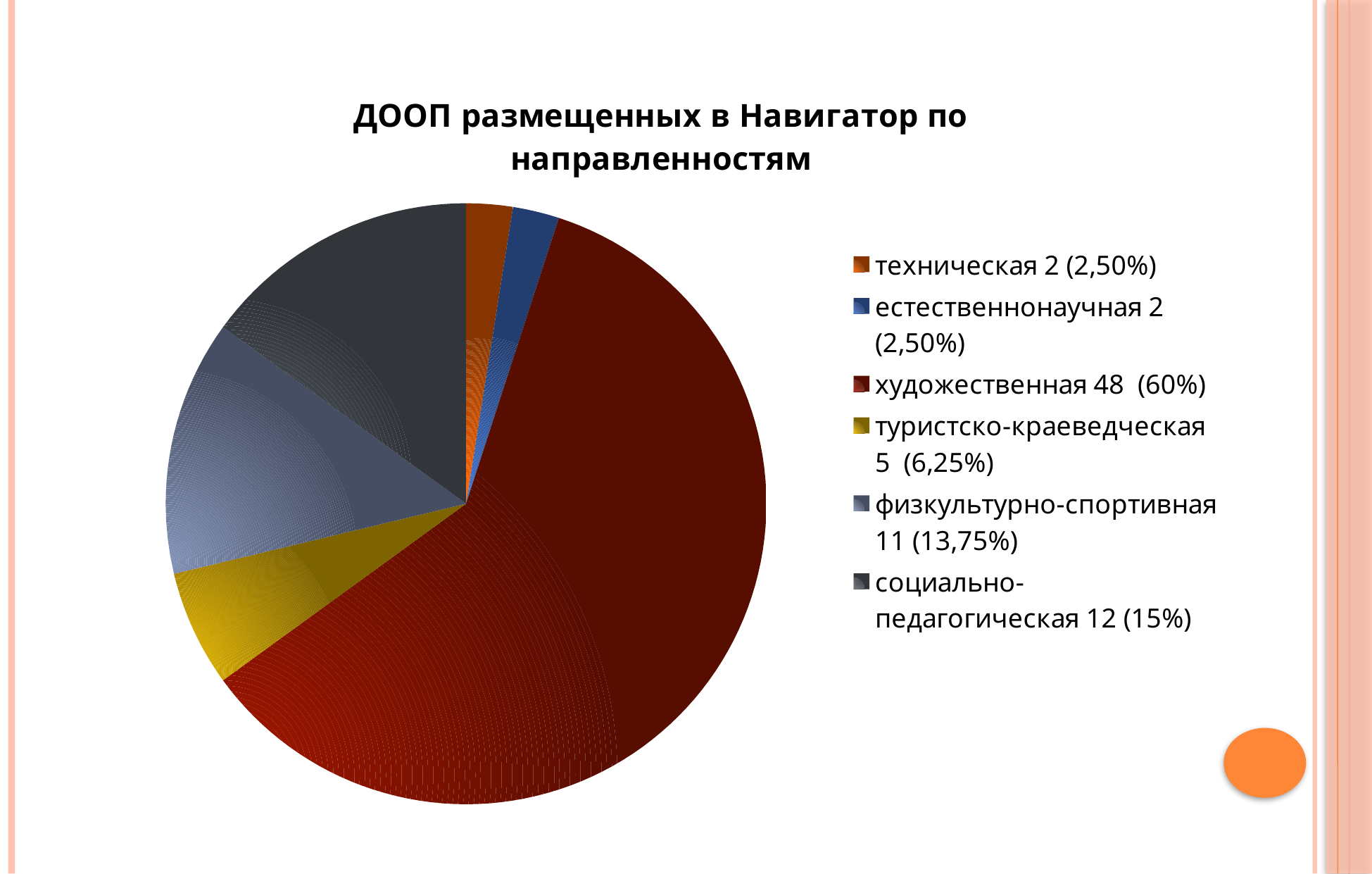
What is the total of all the values shown in the legend? 80 What share of the pie does туристско-краеведческая take? 6,25% What is the title of the chart? ДООП размещенных в Навигатор по направленностям What is the value for художественная? 48 What share of the pie does художественная take? 60% What is the value for физкультурно-спортивная? 11 Which is larger, the value for социально-педагогическая or the value for туристско-краеведческая? социально-педагогическая What share of the pie does социально-педагогическая take? 15% What is the difference between the values for социально-педагогическая and физкультурно-спортивная? 1 How many categories does the pie chart have? 6 Which category has the largest share of the pie? художественная What kind of chart is shown on the slide? pie chart